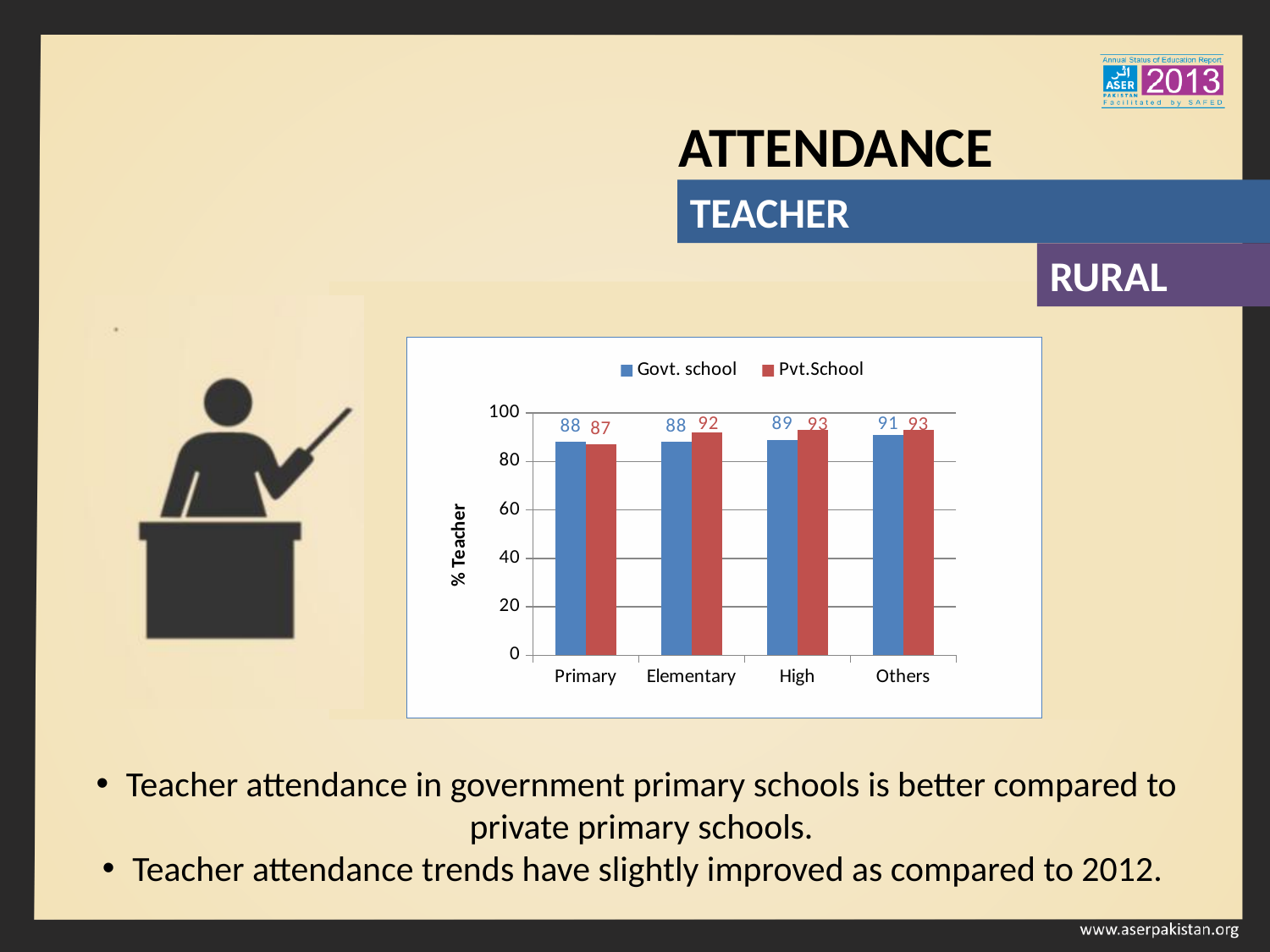
What is the Pvt.School value for Elementary? 92 What is the label of the y axis? % Teacher Which category has the lowest Pvt.School value? Primary What kind of chart is shown on the slide? Bar chart Which category has the highest Pvt.School value? High and Others (both 93) What is the Govt. school value for Primary? 88 What colour are the Pvt.School bars? Red For Primary, which is larger: the Govt. school value or the Pvt.School value? Govt. school What is the Govt. school value for Others? 91 How many categories are shown on the x axis? 4 How many series does the legend list? 2 What is the difference between the Pvt.School and Govt. school values for High? 4